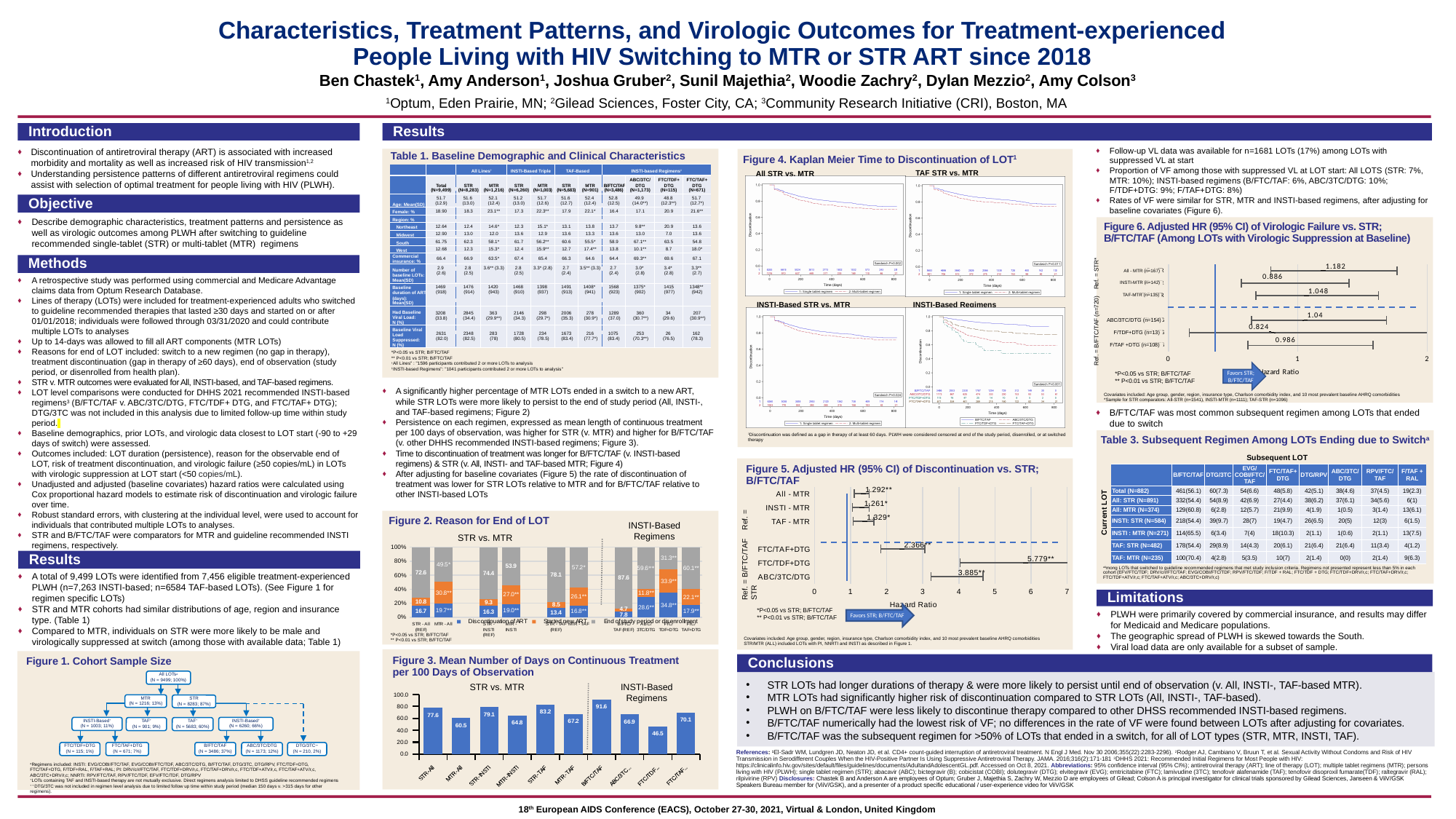
In Figure 3 (Mean Number of Days on Continuous Treatment per 100 Days of Observation), what is the lowest value shown? 46.5 In Figure 3 (Mean Number of Days on Continuous Treatment per 100 Days of Observation), how many bars are plotted? 10 In Figure 5 (Adjusted HR of Discontinuation vs. STR; B/FTC/TAF), what is the hazard ratio for FTC/TDF+DTG? 5.779** In Figure 3 (Mean Number of Days on Continuous Treatment per 100 Days of Observation), what is the value for B/FTC/TAF? 91.6 In Figure 3 (Mean Number of Days on Continuous Treatment per 100 Days of Observation), which is larger, STR-INSTI or MTR-INSTI? STR-INSTI In Figure 3 (Mean Number of Days on Continuous Treatment per 100 Days of Observation), what is the value for STR-All? 77.6 In Figure 2 (Reason for End of LOT), what is the value of the largest segment in the B/FTC/TAF bar? 87.6 In Figure 6 (Adjusted HR of Virologic Failure vs. STR; B/FTC/TAF), what is the hazard ratio for All - MTR? 1.182 In Figure 3 (Mean Number of Days on Continuous Treatment per 100 Days of Observation), what is the difference between STR-TAF and MTR-TAF? 16.0 What kind of chart is Figure 3 (Mean Number of Days on Continuous Treatment per 100 Days of Observation)? Bar chart In Figure 3 (Mean Number of Days on Continuous Treatment per 100 Days of Observation), which category has the highest value? B/FTC/TAF In Figure 5 (Adjusted HR of Discontinuation vs. STR; B/FTC/TAF), which regimen has the highest hazard ratio? FTC/TDF+DTG